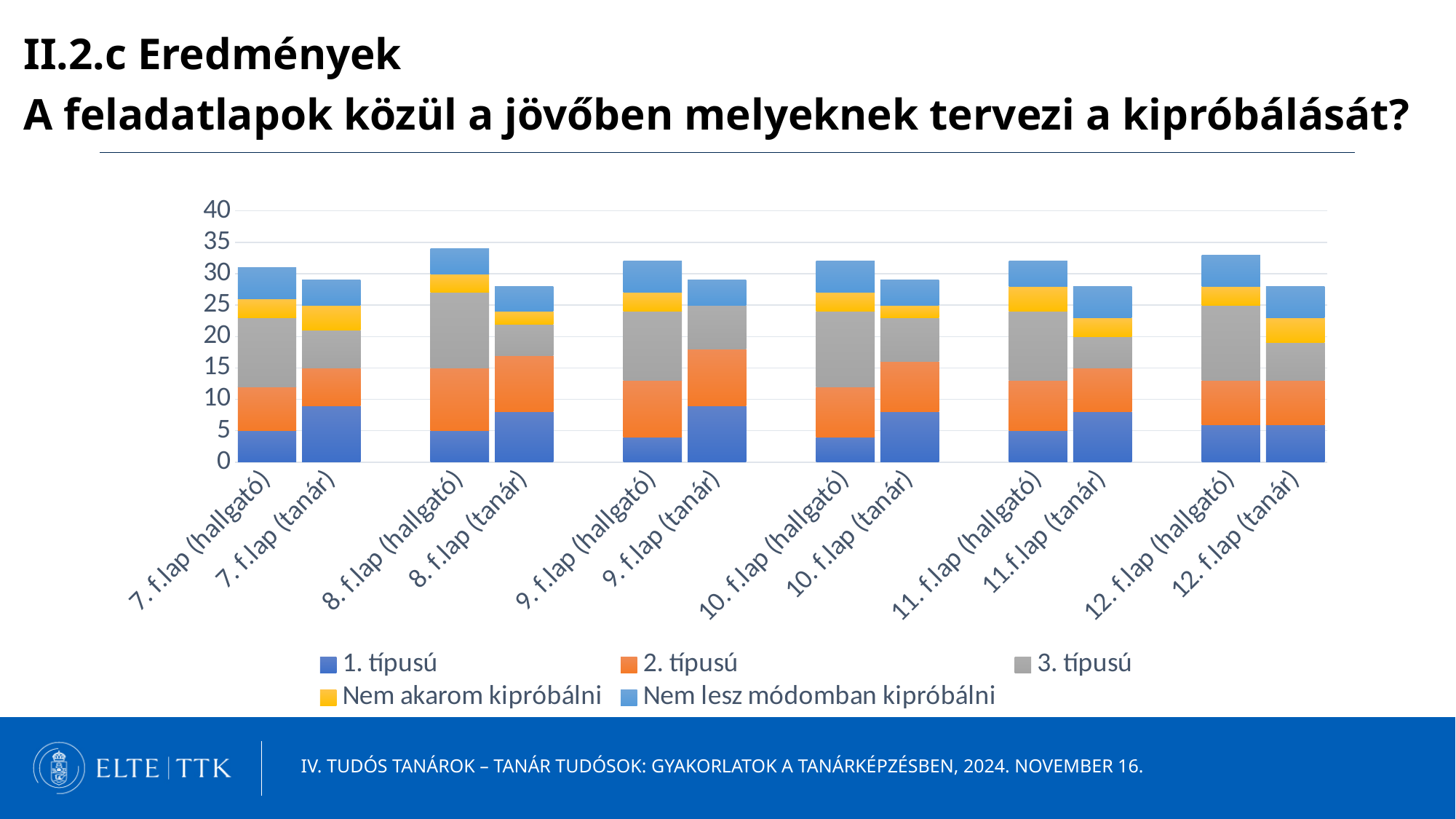
Which colour represents the 3. típusú series in the legend? Grey Is the total for 8. f.lap (hallgató) greater or less than 30? greater Which category has the highest total stacked bar? 8. f.lap (hallgató) Which has the larger 1. típusú value: 7. f.lap (hallgató) or 7. f.lap (tanár)? 7. f.lap (tanár) How many series does the legend list? 5 Is the 1. típusú value for 9. f.lap (hallgató) greater or less than 5? less Which has the larger total: 8. f.lap (hallgató) or 8. f.lap (tanár)? 8. f.lap (hallgató) Is the 1. típusú value for 7. f.lap (tanár) greater or less than 5? greater How many categories (bars) are shown along the x axis? 12 What is the last legend entry listed? Nem lesz módomban kipróbálni What kind of chart is shown on the slide? Stacked bar chart